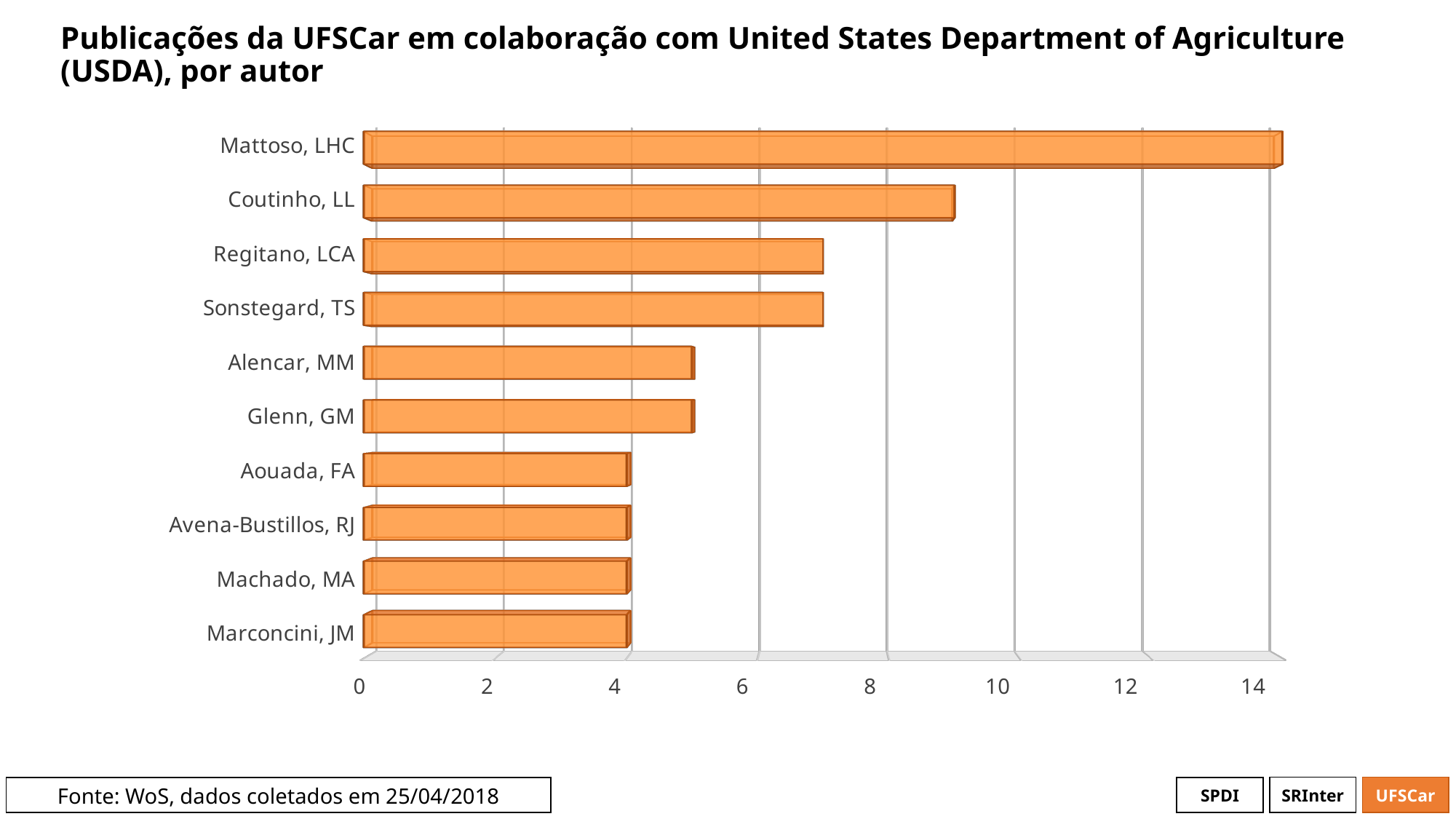
Is the value for Sonstegard, TS greater or less than 8? less What is the title of the chart? Publicações da UFSCar em colaboração com United States Department of Agriculture (USDA), por autor What kind of chart is shown on the slide? bar chart Which author has the highest number of publications? Mattoso, LHC Is the value for Coutinho, LL greater or less than 8? greater What is the data source stated on the slide? WoS, dados coletados em 25/04/2018 Is the value for Mattoso, LHC greater or less than 12? greater Which has more publications, Glenn, GM or Machado, MA? Glenn, GM How many authors are listed on the chart? 10 Which has more publications, Coutinho, LL or Regitano, LCA? Coutinho, LL